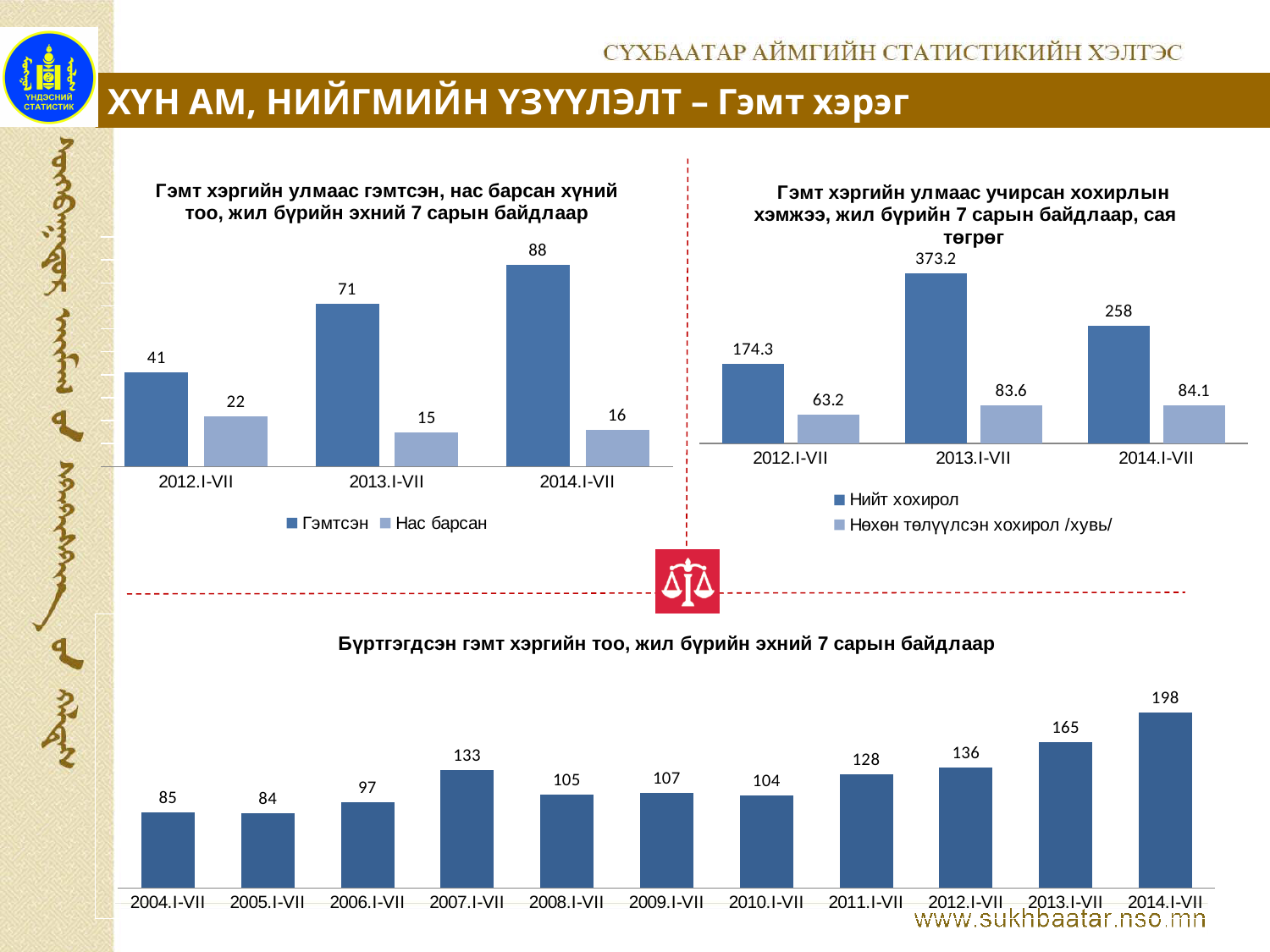
In the top-left chart (Гэмт хэргийн улмаас гэмтсэн, нас барсан хүний тоо), what is the difference between Гэмтсэн and Нас барсан in 2012.I-VII? 19 In the top-right chart (Гэмт хэргийн улмаас учирсан хохирлын хэмжээ), which is larger: Нийт хохирол in 2012.I-VII or in 2014.I-VII? 2014.I-VII In the top-left chart (Гэмт хэргийн улмаас гэмтсэн, нас барсан хүний тоо), how many series does the legend list? 2 In the top-right chart (Гэмт хэргийн улмаас учирсан хохирлын хэмжээ), what is the value for Нийт хохирол in 2013.I-VII? 373.2 In the top-right chart (Гэмт хэргийн улмаас учирсан хохирлын хэмжээ), what is the value for Нөхөн төлүүлсэн хохирол /хувь/ in 2014.I-VII? 84.1 In the bottom chart (Бүртгэгдсэн гэмт хэргийн тоо), how many years are shown on the x axis? 11 In the top-left chart (Гэмт хэргийн улмаас гэмтсэн, нас барсан хүний тоо), what is the value for Гэмтсэн in 2014.I-VII? 88 In the bottom chart (Бүртгэгдсэн гэмт хэргийн тоо), what is the value for 2007.I-VII? 133 In the top-left chart (Гэмт хэргийн улмаас гэмтсэн, нас барсан хүний тоо), what is the value for Нас барсан in 2013.I-VII? 15 In the bottom chart (Бүртгэгдсэн гэмт хэргийн тоо), which year has the lowest value? 2005.I-VII In the top-right chart (Гэмт хэргийн улмаас учирсан хохирлын хэмжээ), which year has the highest Нийт хохирол? 2013.I-VII What kind of chart is the bottom chart (Бүртгэгдсэн гэмт хэргийн тоо)? Bar chart